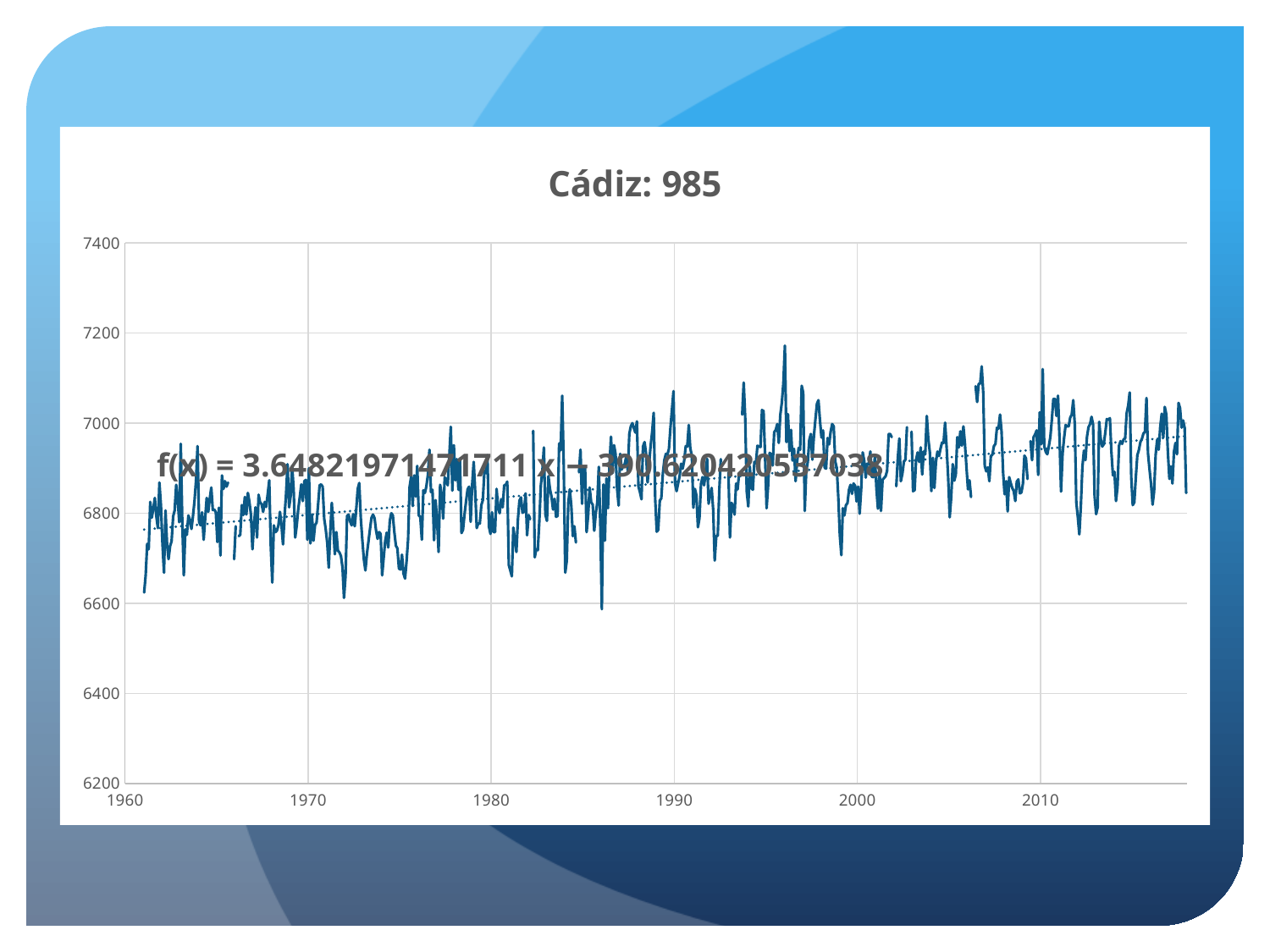
Is the value of the series at the start, around 1961, greater or less than 6800? less What kind of chart is shown on the slide? line chart What is the slope of the trendline equation shown on the chart? 3.64821971471711 What is the title of the chart? Cádiz: 985 Is the highest peak of the series, around 1996, greater or less than 7000? greater Is the value of the trendline at 2010 greater or less than 6800? greater Overall, do the plotted values rise or fall along the x axis from 1960 to 2018? rise Does the trendline on the chart rise or fall from 1960 to 2018? rise